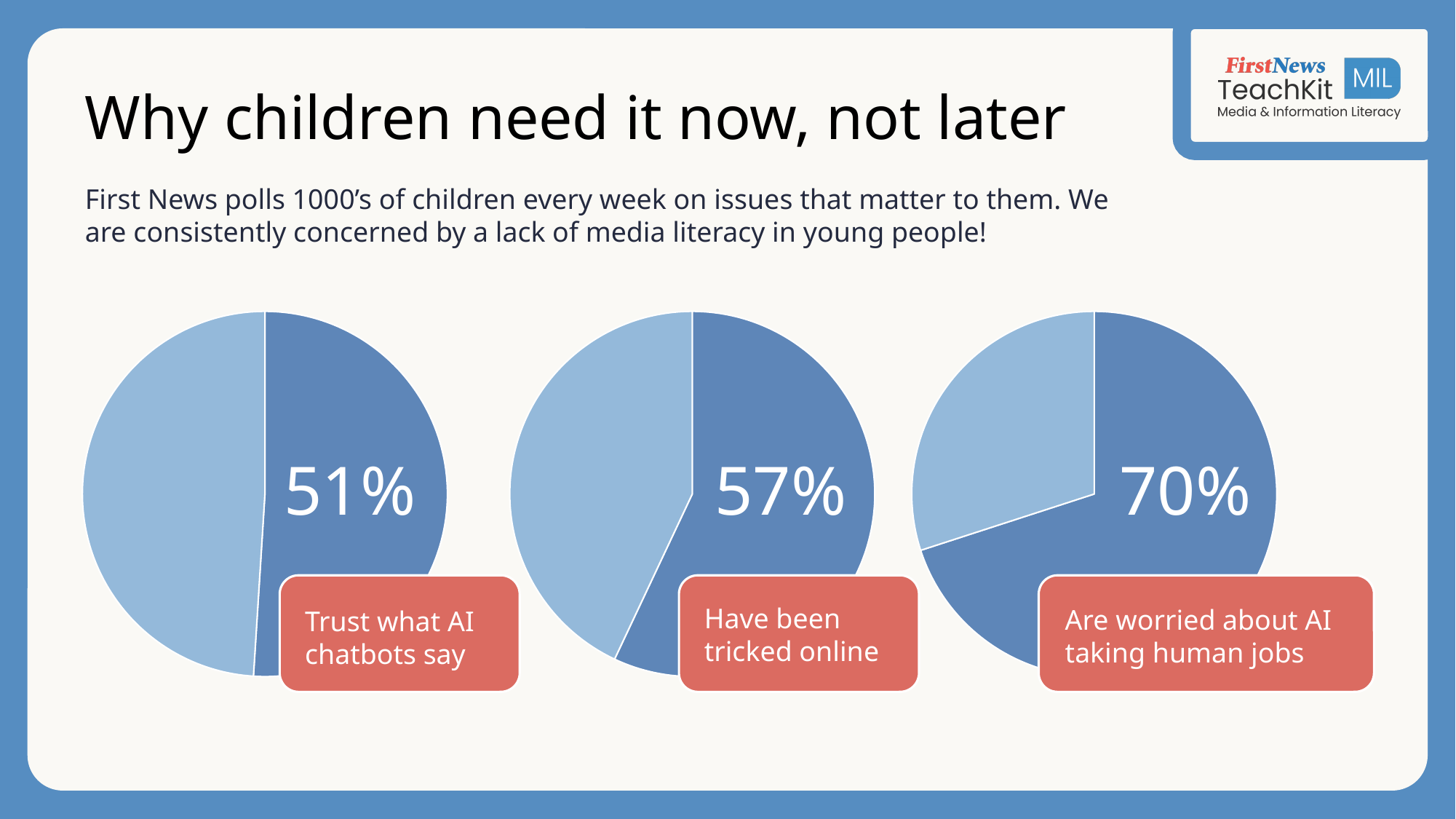
What kind of chart is used to show the three statistics on the slide? Pie chart What is the difference between the percentage worried about AI taking human jobs and the percentage who trust what AI chatbots say? 19% What is the difference between the percentage who have been tricked online and the percentage who trust what AI chatbots say? 6% How many pie charts are shown on the slide? 3 What percentage of children trust what AI chatbots say, according to the left pie chart? 51% What percentage of children have been tricked online, according to the middle pie chart? 57% In the right pie chart, what share of the pie does the dark blue slice represent? 70% What is the title of the slide containing the three pie charts? Why children need it now, not later Which of the three pie charts shows the highest percentage? Are worried about AI taking human jobs Which of the three pie charts shows the lowest percentage? Trust what AI chatbots say Which is larger: the percentage who have been tricked online or the percentage who trust what AI chatbots say? Have been tricked online What percentage of children are worried about AI taking human jobs, according to the right pie chart? 70%